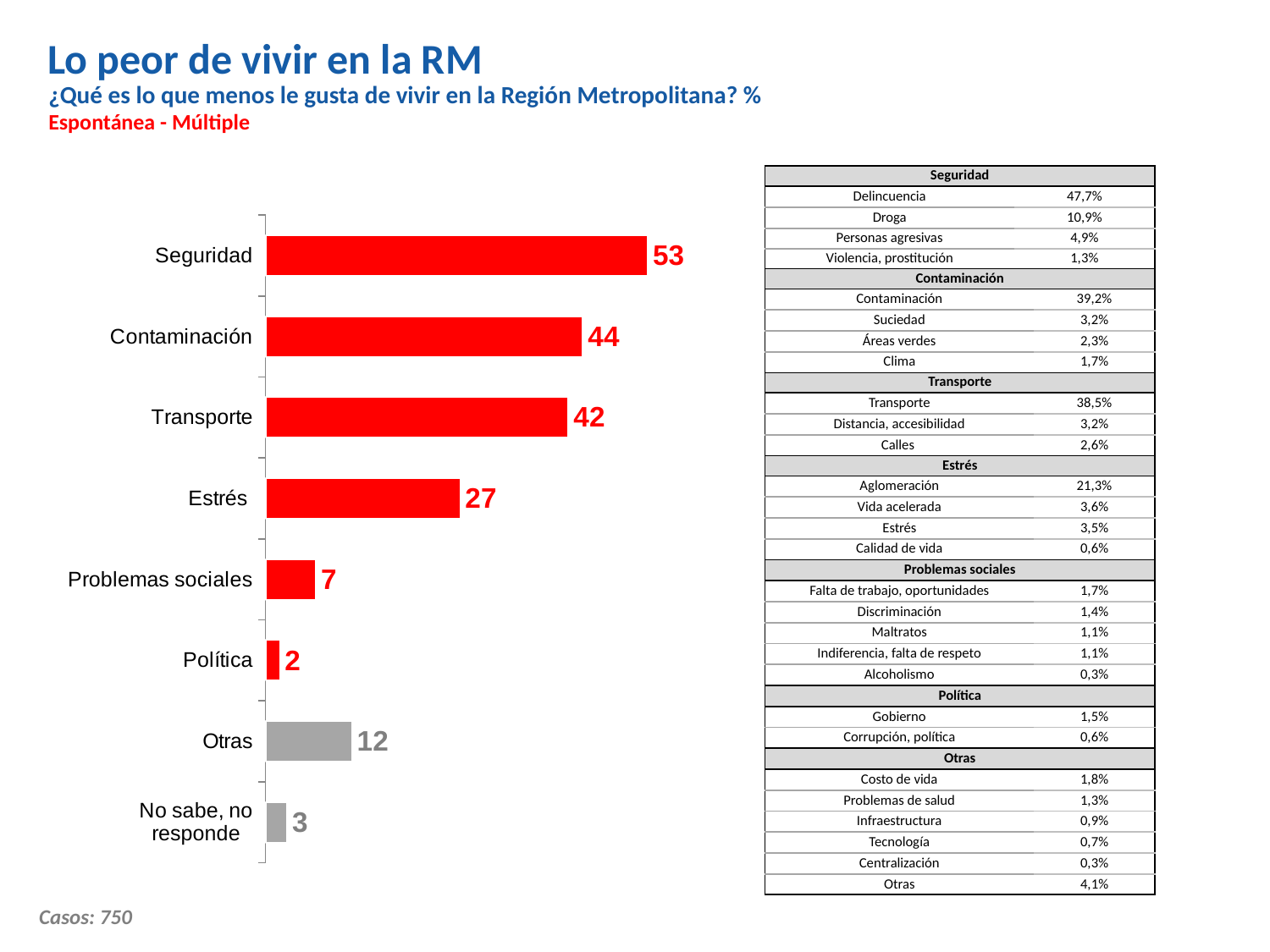
How many categories are shown in the bar chart? 8 What kind of chart is shown on the slide? Bar chart Which is larger, the value for Estrés or the value for Otras? Estrés Which category has the lowest value? Política What is the value for Contaminación? 44 What is the value for Otras? 12 What is the value for Seguridad? 53 What is the difference between the values for Problemas sociales and Política? 5 What is the value for Estrés? 27 Which category has the highest value? Seguridad What is the difference between the values for Seguridad and Contaminación? 9 What is the value for Transporte? 42